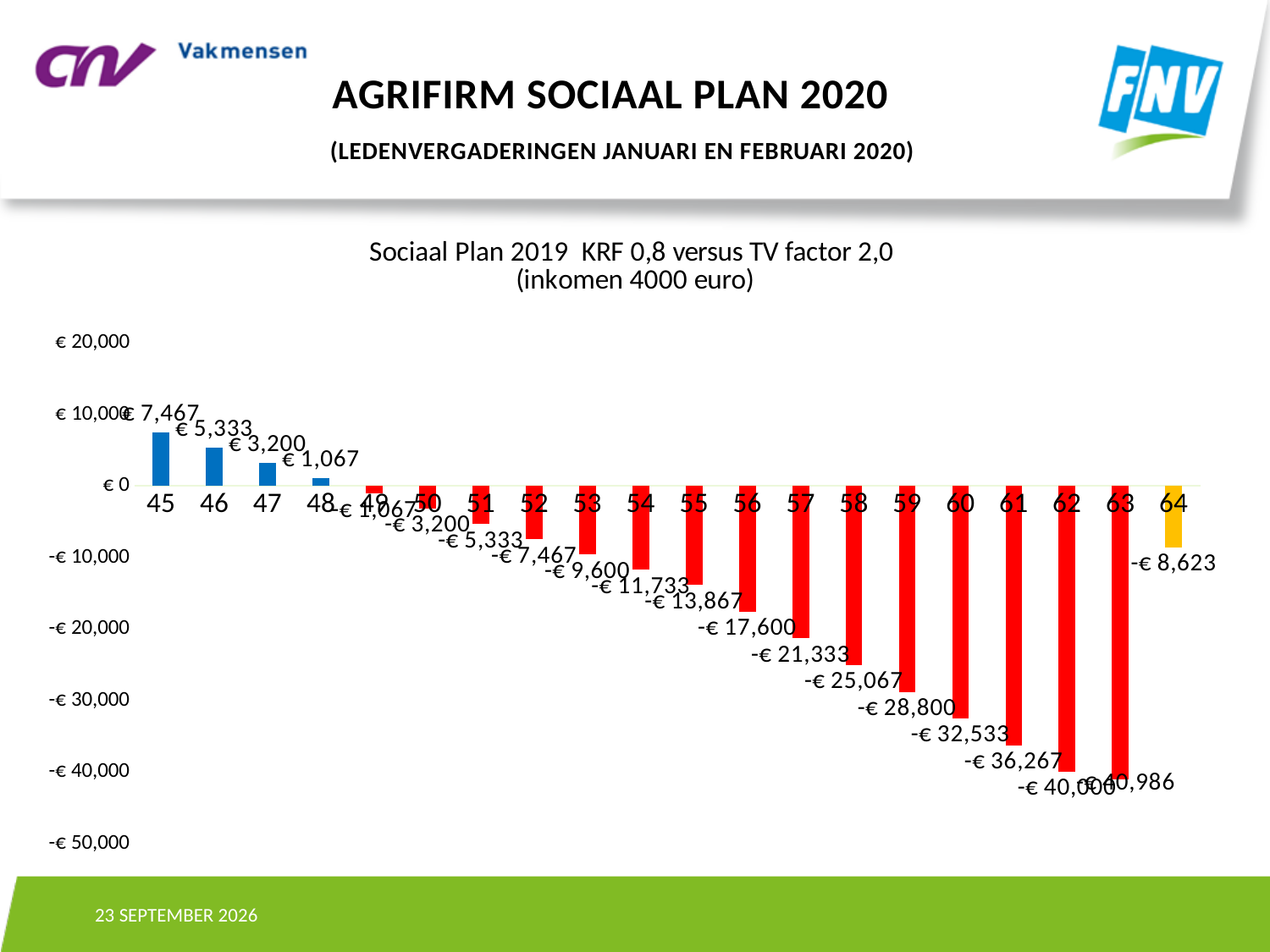
What is the value for category 45? € 7,467 Which category has the lowest value? 63 Which has the larger value, category 46 or category 48? 46 What is the value for category 56? -€ 17,600 Is the value for category 57 greater or less than -€ 20,000? less Which category has the highest value? 45 What is the difference between the values for categories 45 and 46? € 2,134 What is the value for category 60? -€ 32,533 What is the value for category 64? -€ 8,623 What type of chart is shown on the slide? bar chart How many categories are shown on the x axis? 20 What is the value for category 47? € 3,200